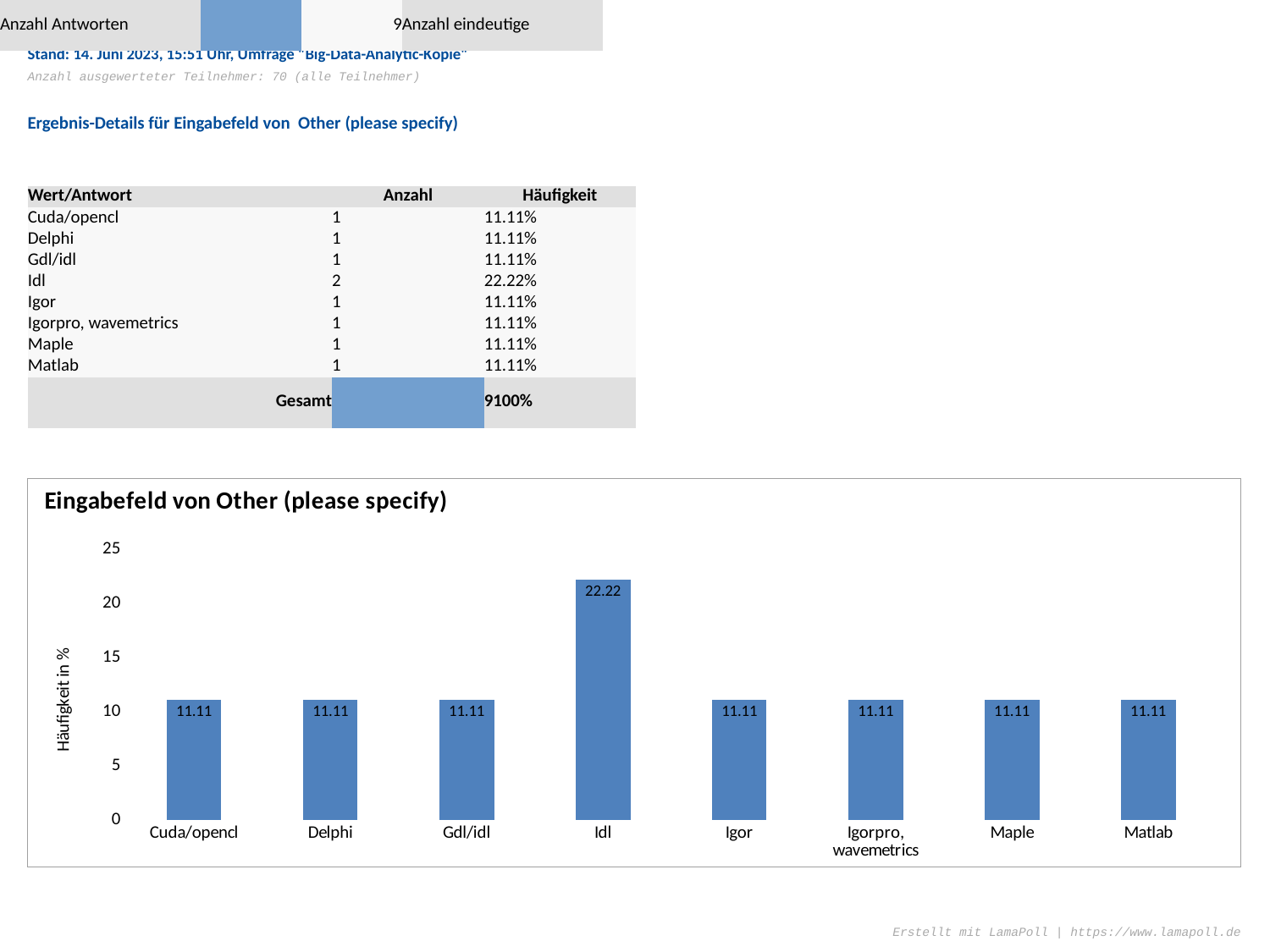
Is the value for Cuda/opencl greater or less than 15? less What is the value for Matlab in the chart? 11.11 What is the value for Idl in the chart? 22.22 What is the value for Delphi in the chart? 11.11 Is the value for Idl greater or less than 20? greater What is the title of the chart? Eingabefeld von Other (please specify) What is the label of the y axis in the chart? Häufigkeit in % What type of chart is shown on the slide? bar chart Which is larger, the value for Idl or the value for Igor? Idl What is the difference between the values for Idl and Maple? 11.11 Which category has the highest value in the chart? Idl How many categories are plotted in the chart? 8